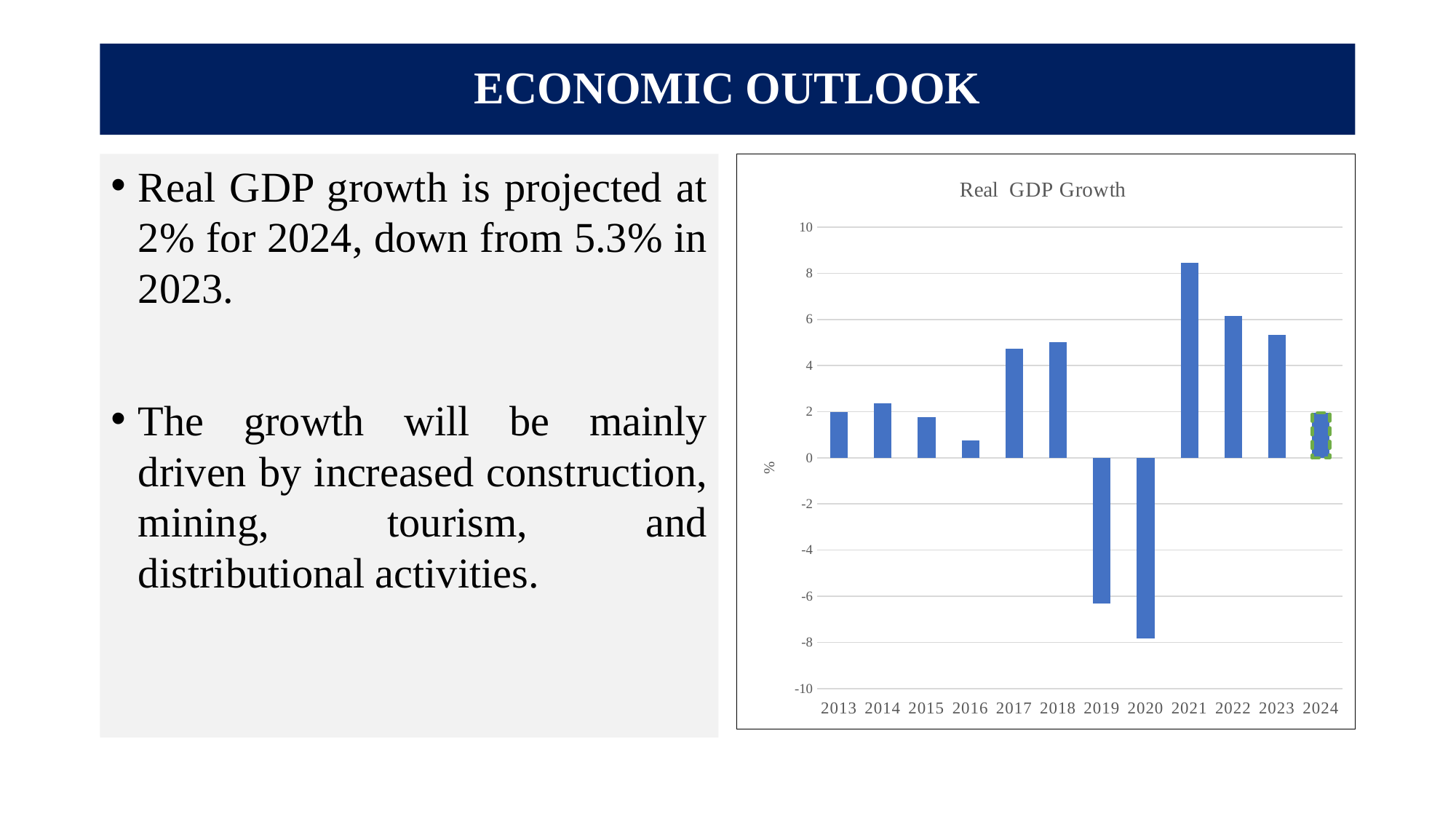
How many years are plotted on the x axis of the chart? 12 Is the value for 2018 greater or less than 4? greater Is the value for 2021 greater or less than 8? greater Is the value for 2020 greater or less than -6? less Which year has the larger Real GDP Growth, 2014 or 2016? 2014 Which year has the lowest Real GDP Growth in the chart? 2020 How many years in the chart show negative Real GDP Growth? 2 Which year has the larger Real GDP Growth, 2022 or 2023? 2022 Which year has the highest Real GDP Growth in the chart? 2021 What kind of chart is shown on the slide? bar chart What is the title of the chart? Real GDP Growth